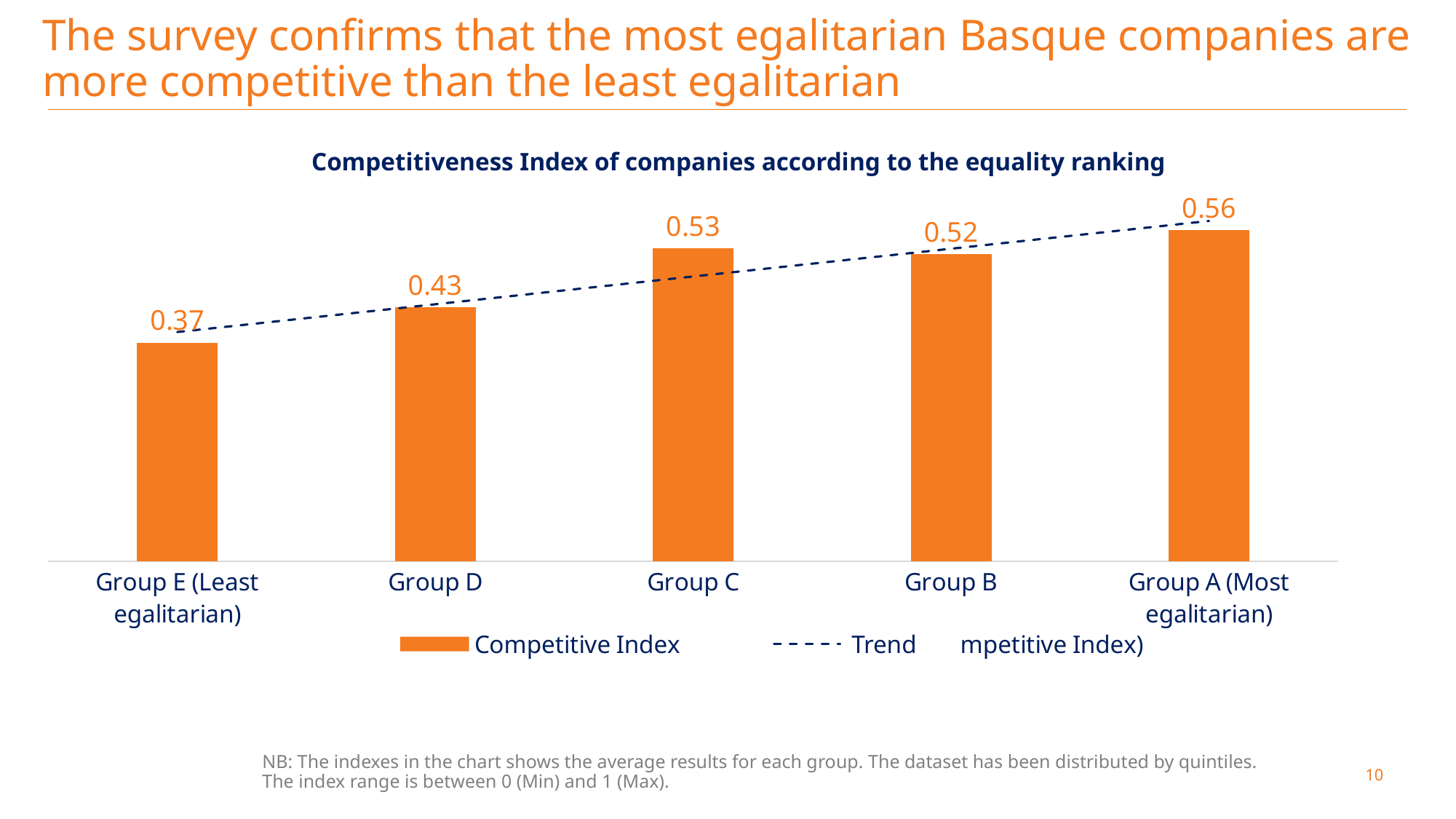
What is the difference between the Competitive Index of Group A (Most egalitarian) and Group E (Least egalitarian)? 0.19 Which group has the lowest Competitive Index? Group E (Least egalitarian) What is the Competitive Index value for Group C? 0.53 How many groups are shown on the x axis of the chart? 5 What is the Competitive Index value for Group E (Least egalitarian)? 0.37 What is the difference between the Competitive Index of Group C and Group D? 0.10 What is the Competitive Index value for Group D? 0.43 Does the Competitive Index generally rise or fall from Group E (Least egalitarian) to Group A (Most egalitarian)? Rise What kind of chart is used to show the Competitive Index? Bar chart Which group has the highest Competitive Index? Group A (Most egalitarian) What is the title of the chart? Competitiveness Index of companies according to the equality ranking Which has a higher Competitive Index, Group C or Group B? Group C